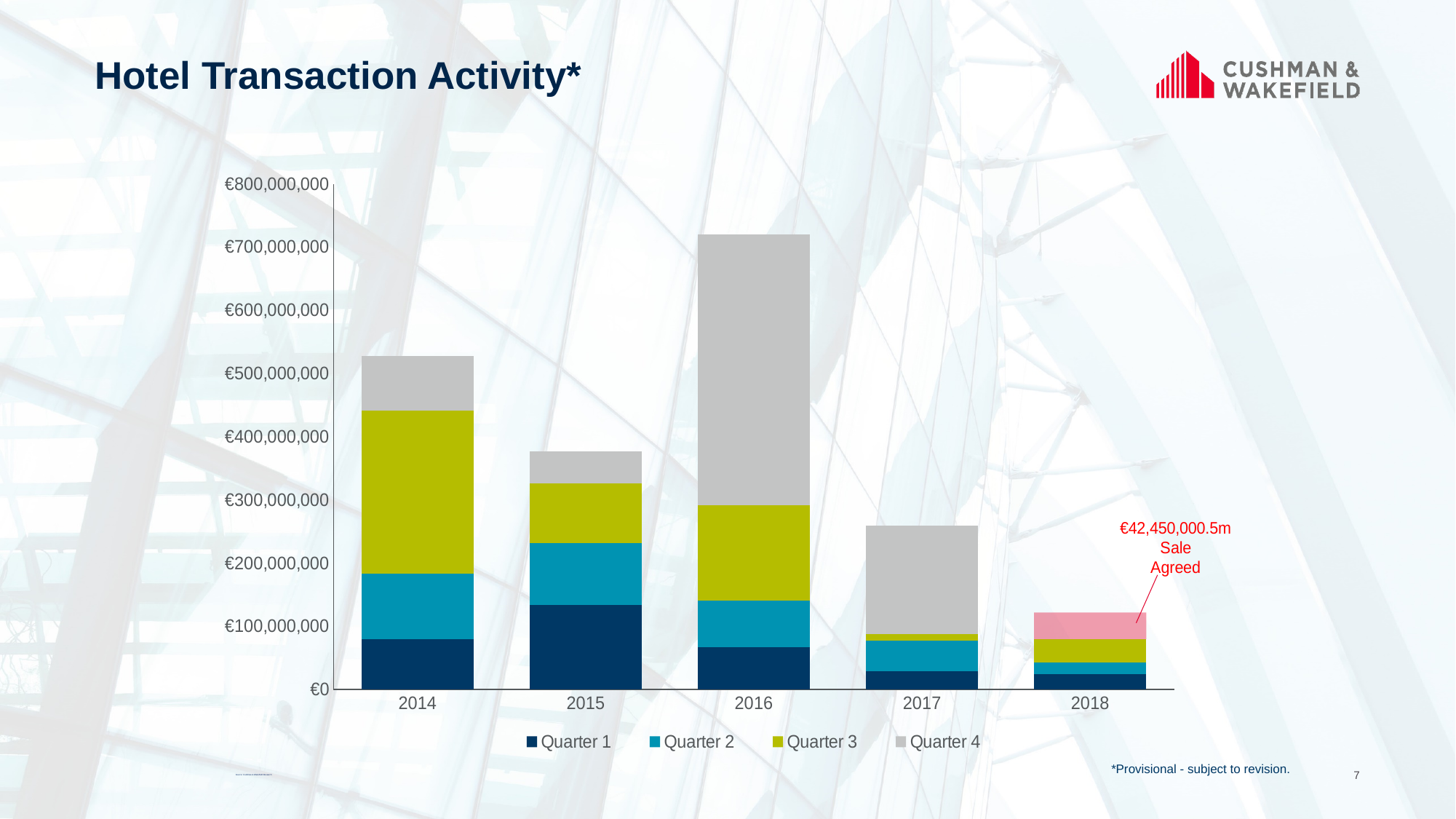
How many years are shown on the x axis of the chart? 5 What kind of chart is shown on the slide? Stacked bar chart Do the yearly totals rise or fall from 2016 to 2018? Fall Is the total for 2017 greater or less than €300,000,000? less Is the total for 2014 greater or less than €500,000,000? greater Which year has the highest total hotel transaction activity? 2016 Is the total for 2016 greater or less than €600,000,000? greater Which year has the lowest total hotel transaction activity? 2018 What value is given in the red annotation for the sale agreed in 2018? €42,450,000.5m How many series does the legend list? 4 Which year has a larger total, 2014 or 2015? 2014